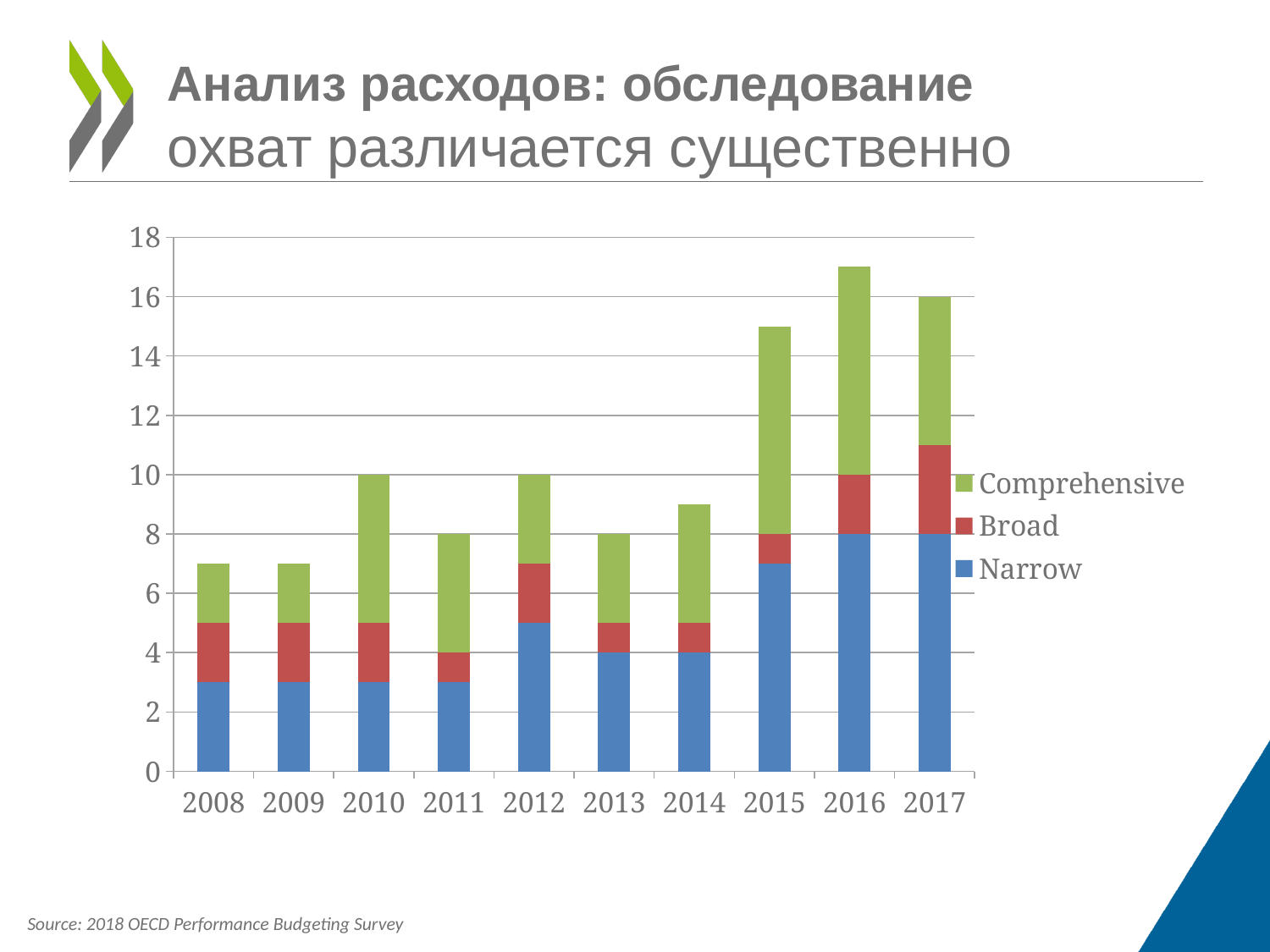
How many series does the legend list? 3 Which year has the tallest stacked bar? 2016 What is the total height of the stacked bar for 2010? 10 What is the value of the Narrow segment for 2016? 8 What kind of chart is shown on the slide? Stacked bar chart Is the total for 2016 greater or less than 16? greater Is the total for 2008 greater or less than 8? less Which legend entry is shown in green? Comprehensive What is the total height of the stacked bar for 2017? 16 Which year has the larger total, 2014 or 2015? 2015 Do the stacked bar totals generally rise or fall from 2008 to 2017? Rise How many years are shown on the x axis? 10